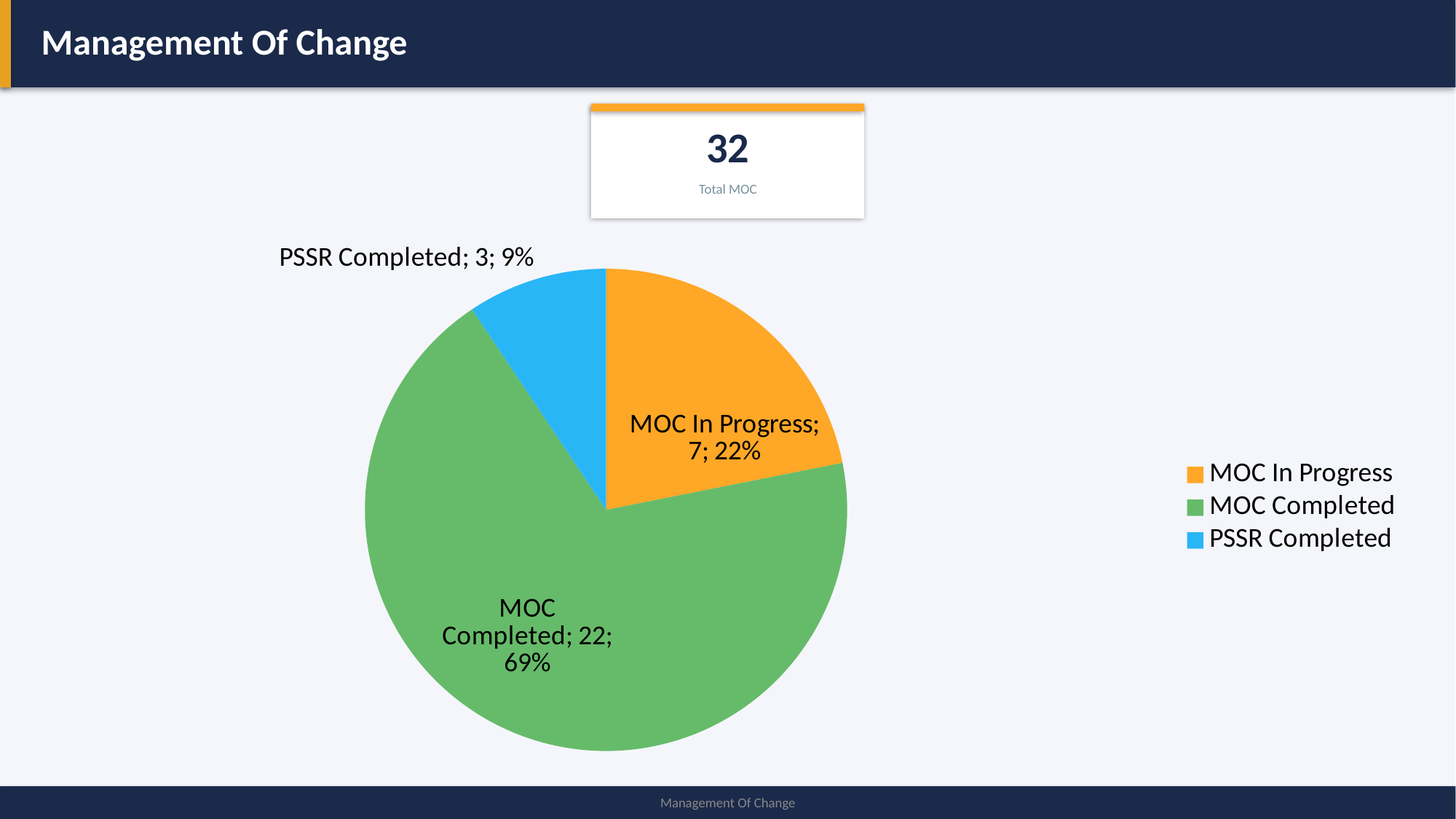
What is the value for MOC Completed? 22 What is the value for PSSR Completed? 3 Which category has the smallest slice? PSSR Completed Which colour represents MOC In Progress in the pie chart? orange What share of the pie does PSSR Completed represent? 9% What share of the pie does MOC Completed represent? 69% What kind of chart is shown on the slide? pie chart How many slices does the pie chart have? 3 Which category has the largest slice? MOC Completed How many entries does the legend list? 3 What is the difference between the values for MOC Completed and MOC In Progress? 15 What is the value for MOC In Progress? 7